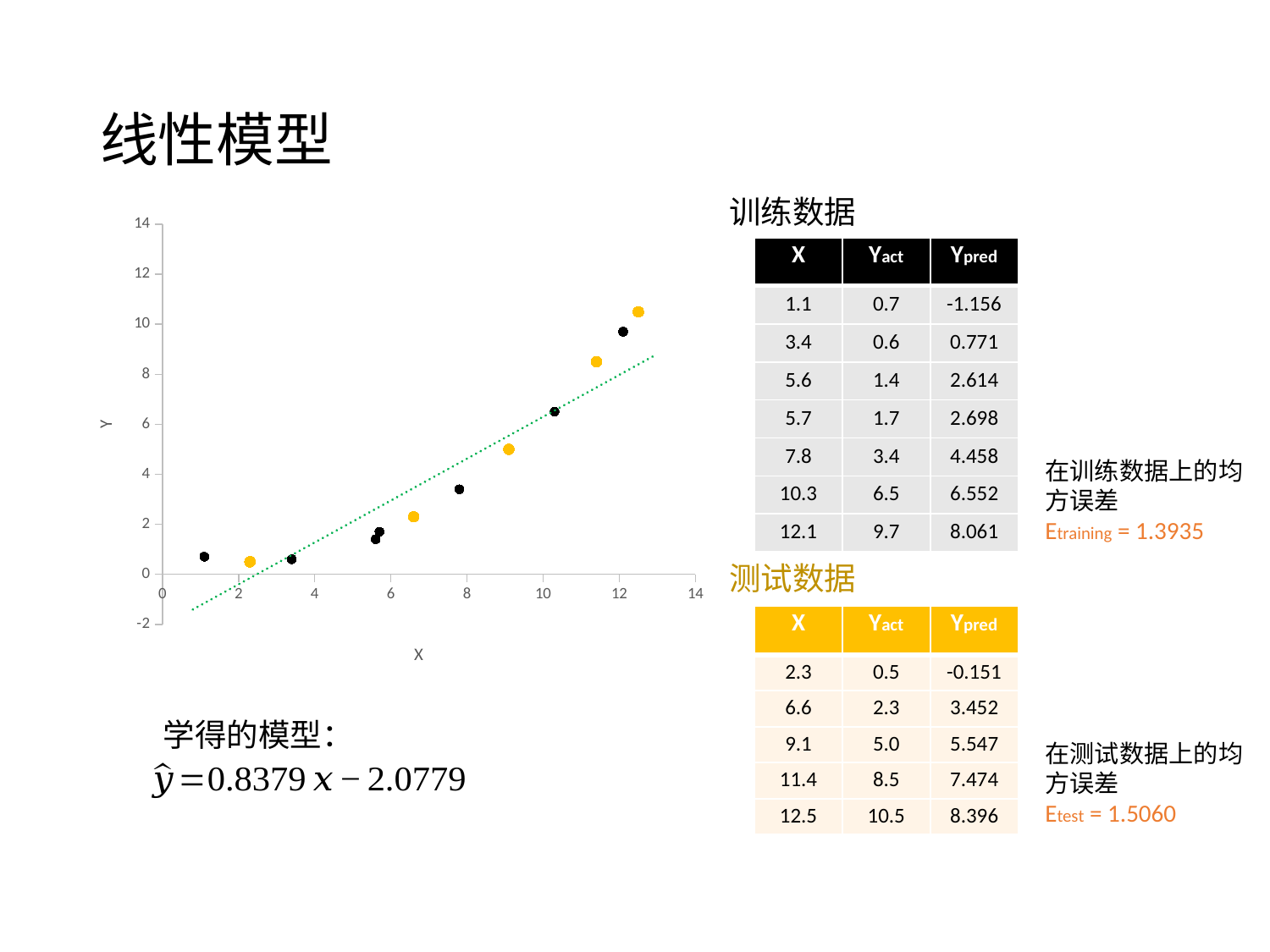
What is the label of the vertical axis of the chart? Y Is the Y value of the rightmost orange point (at X = 12.5) greater or less than 10? greater Do the plotted Y values generally rise or fall as X increases? rise How many orange (test) points are plotted in the chart? 5 How many black (training) points are plotted in the chart? 7 What kind of chart is shown on the left of the slide? scatter chart Is the Y value of the black point near X = 1 greater or less than 2? less According to the training data table, what is the actual Y value (Yact) for X = 10.3? 6.5 According to the test data table, what is the predicted Y value (Ypred) for X = 12.5? 8.396 How many data points are plotted in the chart in total (black and orange)? 12 What is the highest tick value shown on the horizontal axis of the chart? 14 Which point has the highest Y value in the chart, the black point near X = 12.1 or the orange point near X = 12.5? the orange point near X = 12.5